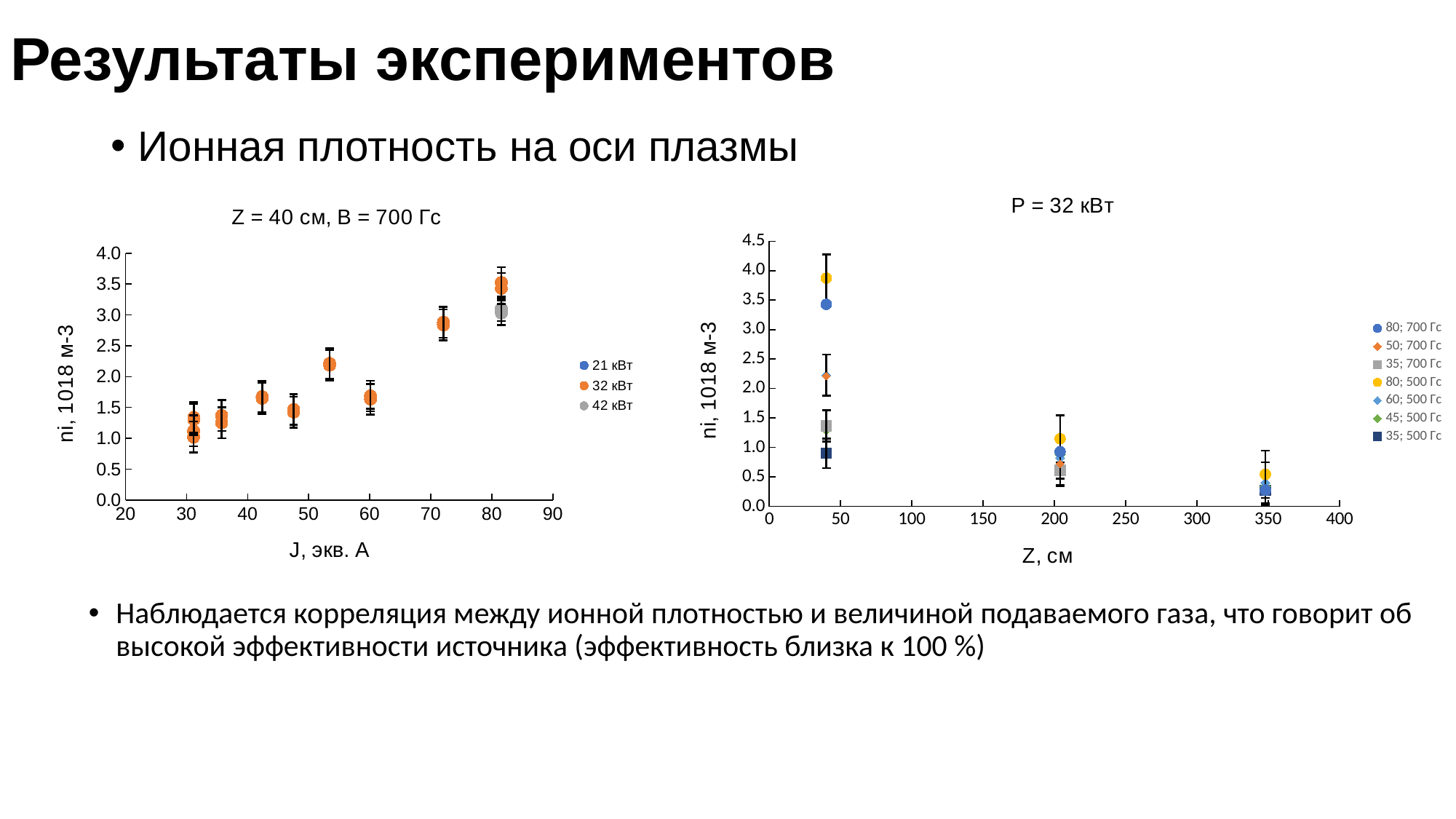
In the right chart (P = 32 кВт), is the '80; 700 Гс' value at Z ≈ 40 см greater or less than 3.0? greater What is the x-axis label of the right chart (P = 32 кВт)? Z, см In the left chart (Z = 40 см, B = 700 Гс), do the values of the 32 кВт series rise or fall as J increases? rise What kind of chart is the left chart titled 'Z = 40 см, B = 700 Гс'? scatter chart In the right chart (P = 32 кВт), is the '80; 500 Гс' value at Z ≈ 40 см greater or less than 3.5? greater In the right chart (P = 32 кВт), is the '80; 500 Гс' value at Z ≈ 350 см greater or less than 1.0? less In the right chart (P = 32 кВт), do the ion density values rise or fall as Z increases? fall How many series does the legend of the right chart (P = 32 кВт) list? 7 How many series does the legend of the left chart (Z = 40 см, B = 700 Гс) list? 3